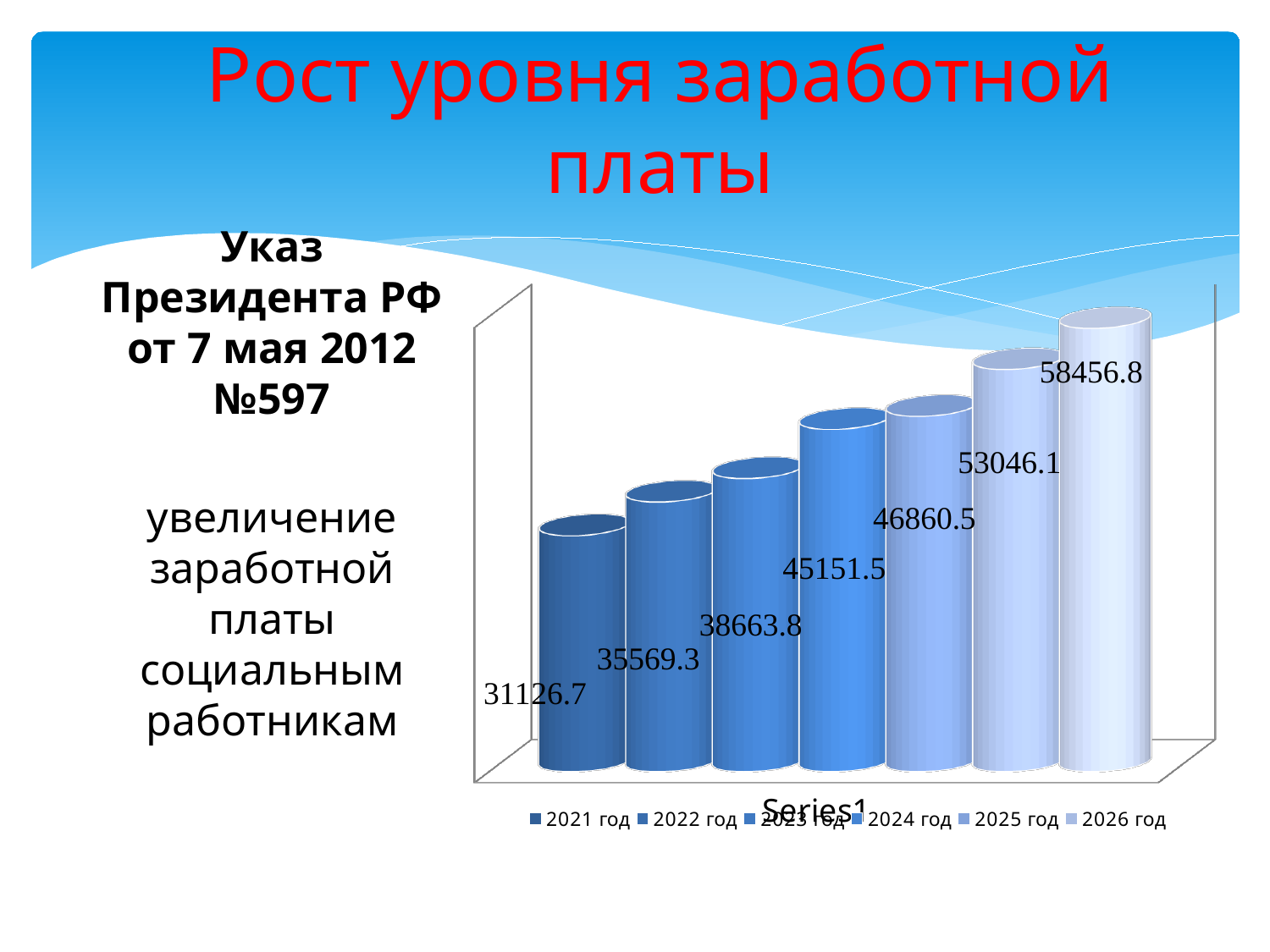
What is the difference between the highest and lowest labelled values in the chart? 27330.1 What is the value shown on the leftmost (first) bar of the chart? 31126.7 Do the bar values rise or fall from left to right across the chart? rise What is the lowest value labelled in the chart? 31126.7 What is the difference between the second bar (35569.3) and the first bar (31126.7)? 4442.6 What type of chart is shown on the slide? bar chart What is the value shown on the rightmost (last) bar of the chart? 58456.8 What is the highest value labelled in the chart? 58456.8 How many bars are plotted in the chart? 7 How many entries does the chart legend list? 6 What is the value shown on the third bar from the left? 38663.8 What is the first entry listed in the chart legend? 2021 год